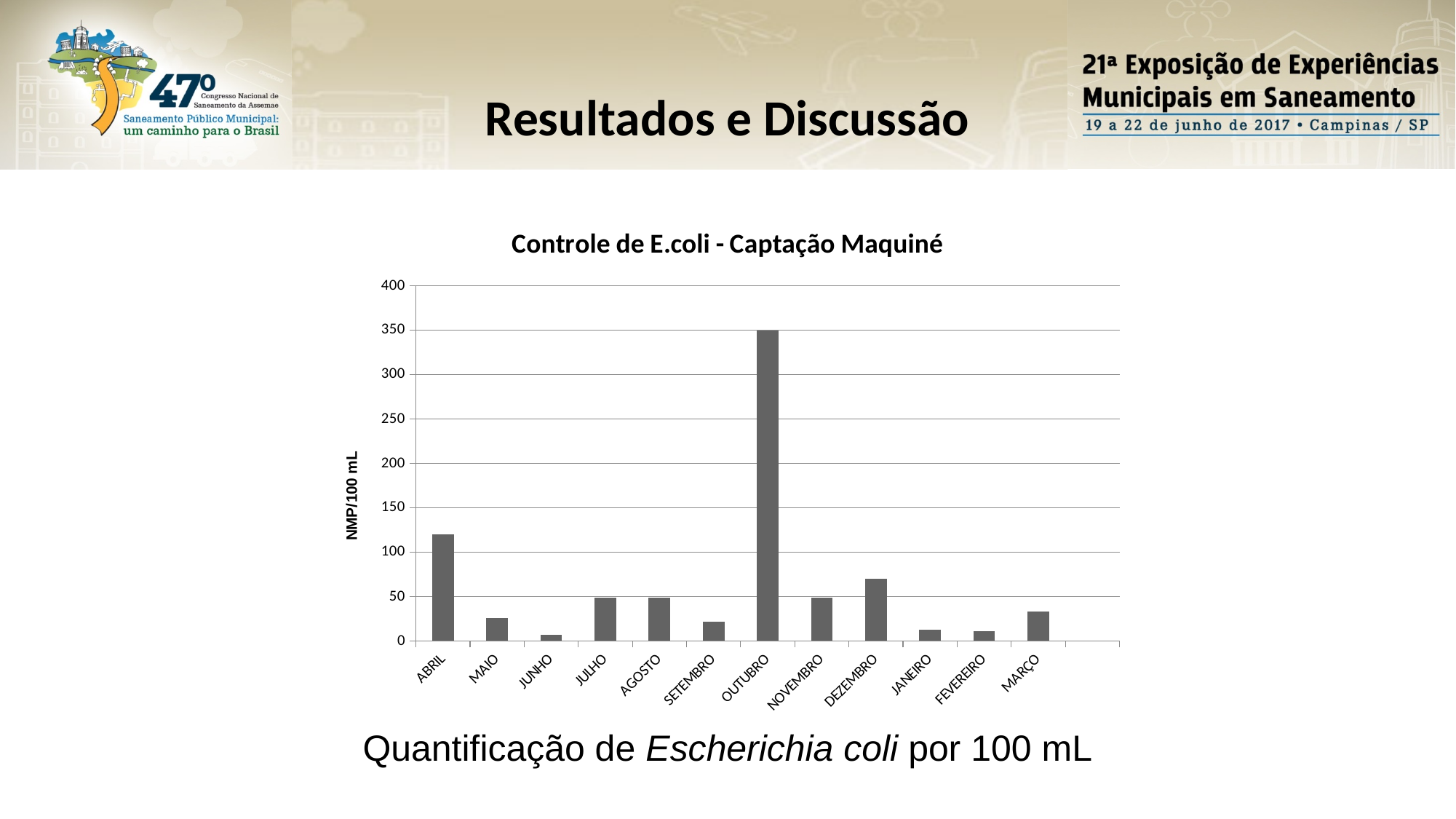
What is the title of the chart? Controle de E.coli - Captação Maquiné Which month has the highest value in the chart? OUTUBRO Is the value for MAIO greater or less than 50? less Which is larger, the value for DEZEMBRO or the value for SETEMBRO? DEZEMBRO Is the value for JUNHO greater or less than 50? less Is the value for OUTUBRO greater or less than 300? greater What kind of chart is shown on the slide? bar chart Which is larger, the value for ABRIL or the value for DEZEMBRO? ABRIL What is the label on the vertical axis of the chart? NMP/100 mL How many months are shown on the x axis of the chart? 12